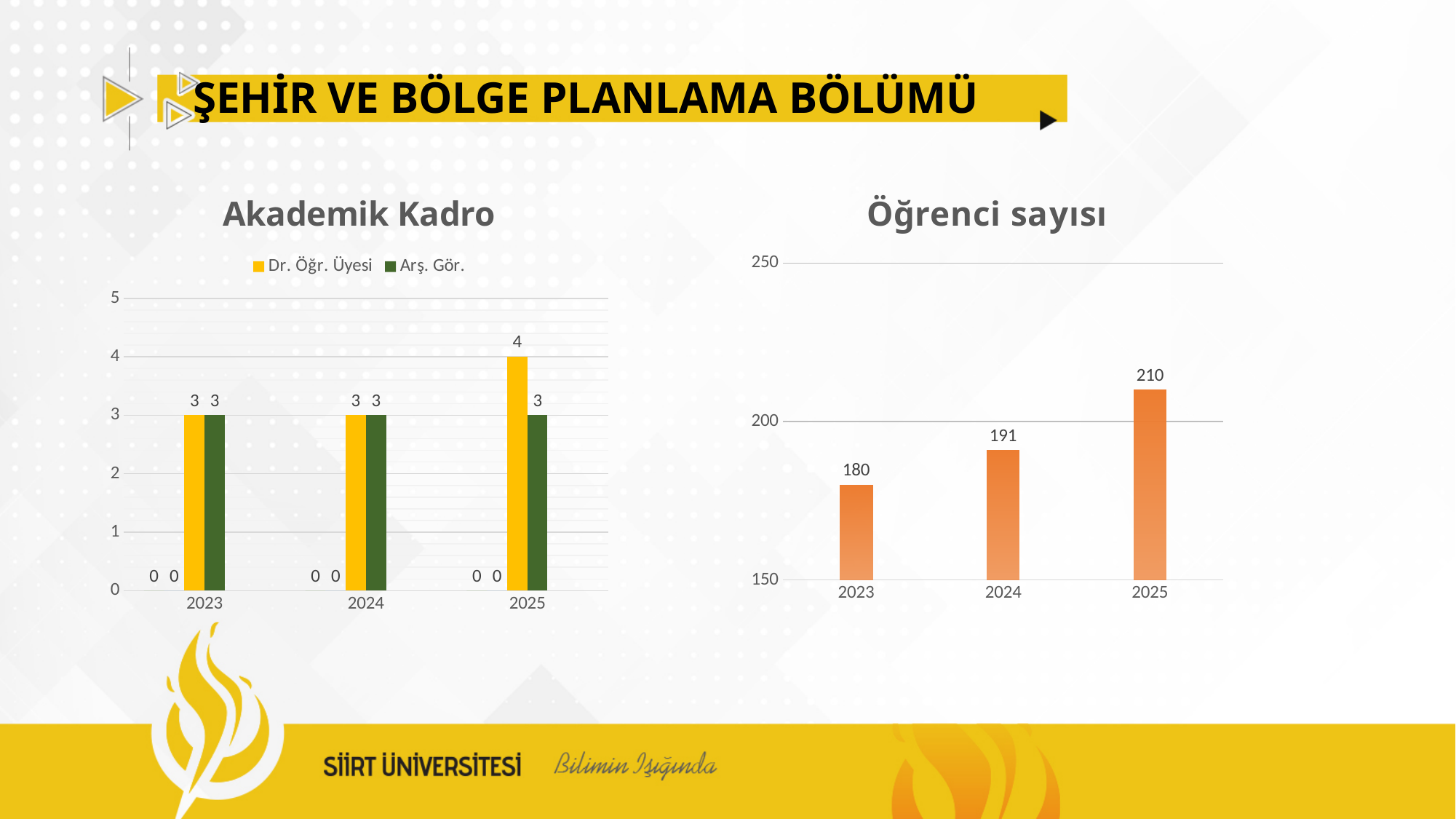
In the 'Öğrenci sayısı' chart, what is the value for 2024? 191 In the 'Akademik Kadro' chart, which colour represents Arş. Gör.? Green In the 'Akademik Kadro' chart, what is the value for Dr. Öğr. Üyesi in 2025? 4 In the 'Akademik Kadro' chart, which is larger in 2025, Dr. Öğr. Üyesi or Arş. Gör.? Dr. Öğr. Üyesi In the 'Öğrenci sayısı' chart, which year has the lowest value? 2023 In the 'Öğrenci sayısı' chart, do the values rise or fall from 2023 to 2025? Rise In the 'Akademik Kadro' chart, how many series does the legend list? 2 In the 'Akademik Kadro' chart, what is the value for Arş. Gör. in 2024? 3 In the 'Öğrenci sayısı' chart, which year has the highest value? 2025 In the 'Öğrenci sayısı' chart, what is the difference between the 2025 and 2023 values? 30 What kind of chart is the 'Öğrenci sayısı' chart? Bar chart In the 'Akademik Kadro' chart, what is the difference between Dr. Öğr. Üyesi and Arş. Gör. in 2025? 1